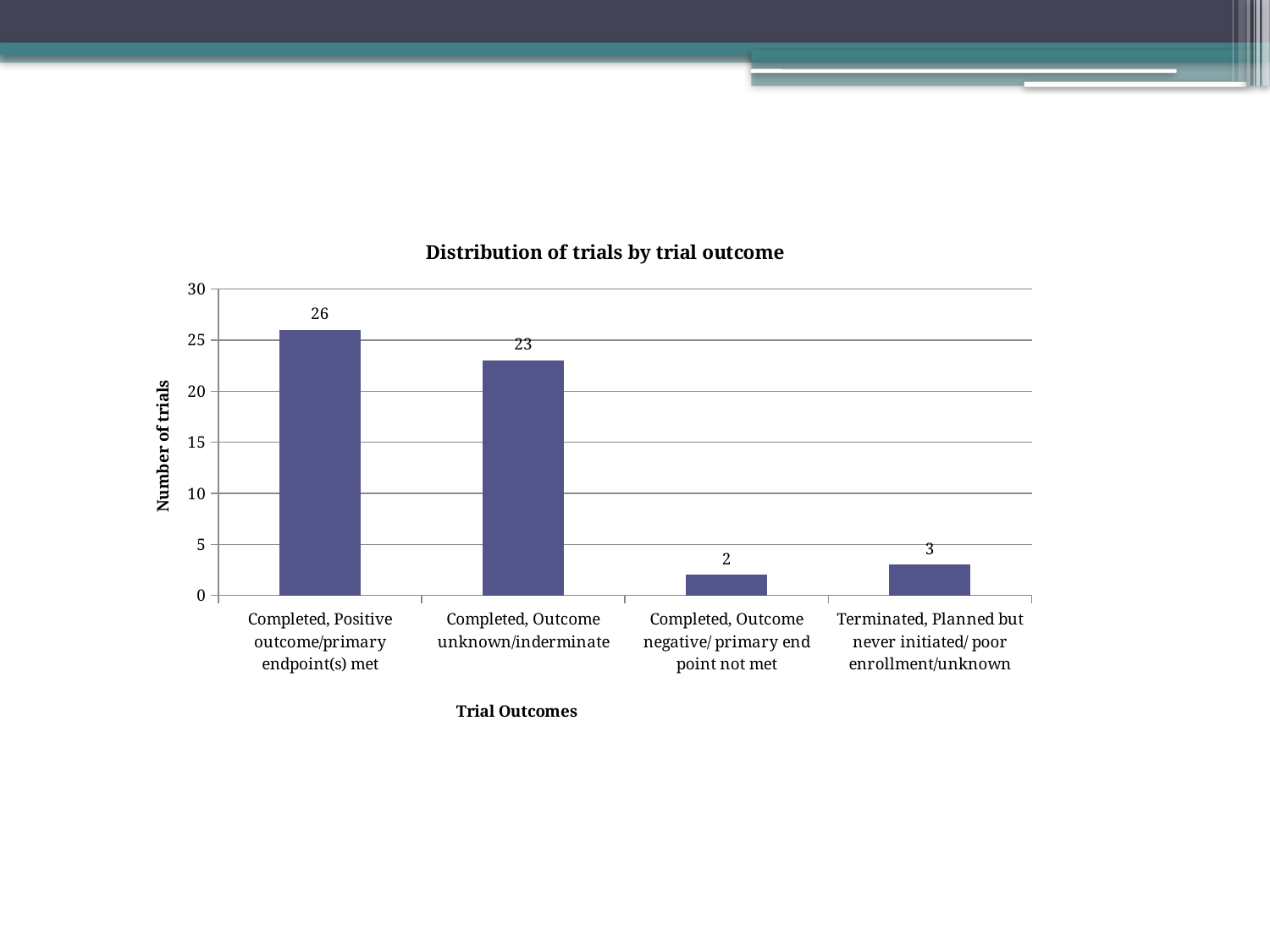
What kind of chart is shown on the slide? Bar chart What is the number of trials for 'Completed, Positive outcome/primary endpoint(s) met'? 26 Which has more trials: 'Terminated, Planned but never initiated/ poor enrollment/unknown' or 'Completed, Outcome negative/ primary end point not met'? Terminated, Planned but never initiated/ poor enrollment/unknown Is the value for 'Completed, Outcome unknown/inderminate' greater or less than 20? greater What is the number of trials for 'Completed, Outcome negative/ primary end point not met'? 2 What is the number of trials for 'Terminated, Planned but never initiated/ poor enrollment/unknown'? 3 Which trial outcome category has the highest number of trials? Completed, Positive outcome/primary endpoint(s) met What is the difference in number of trials between 'Completed, Positive outcome/primary endpoint(s) met' and 'Completed, Outcome unknown/inderminate'? 3 What is the title of the chart? Distribution of trials by trial outcome Which trial outcome category has the lowest number of trials? Completed, Outcome negative/ primary end point not met How many trial outcome categories are shown in the chart? 4 What is the number of trials for 'Completed, Outcome unknown/inderminate'? 23